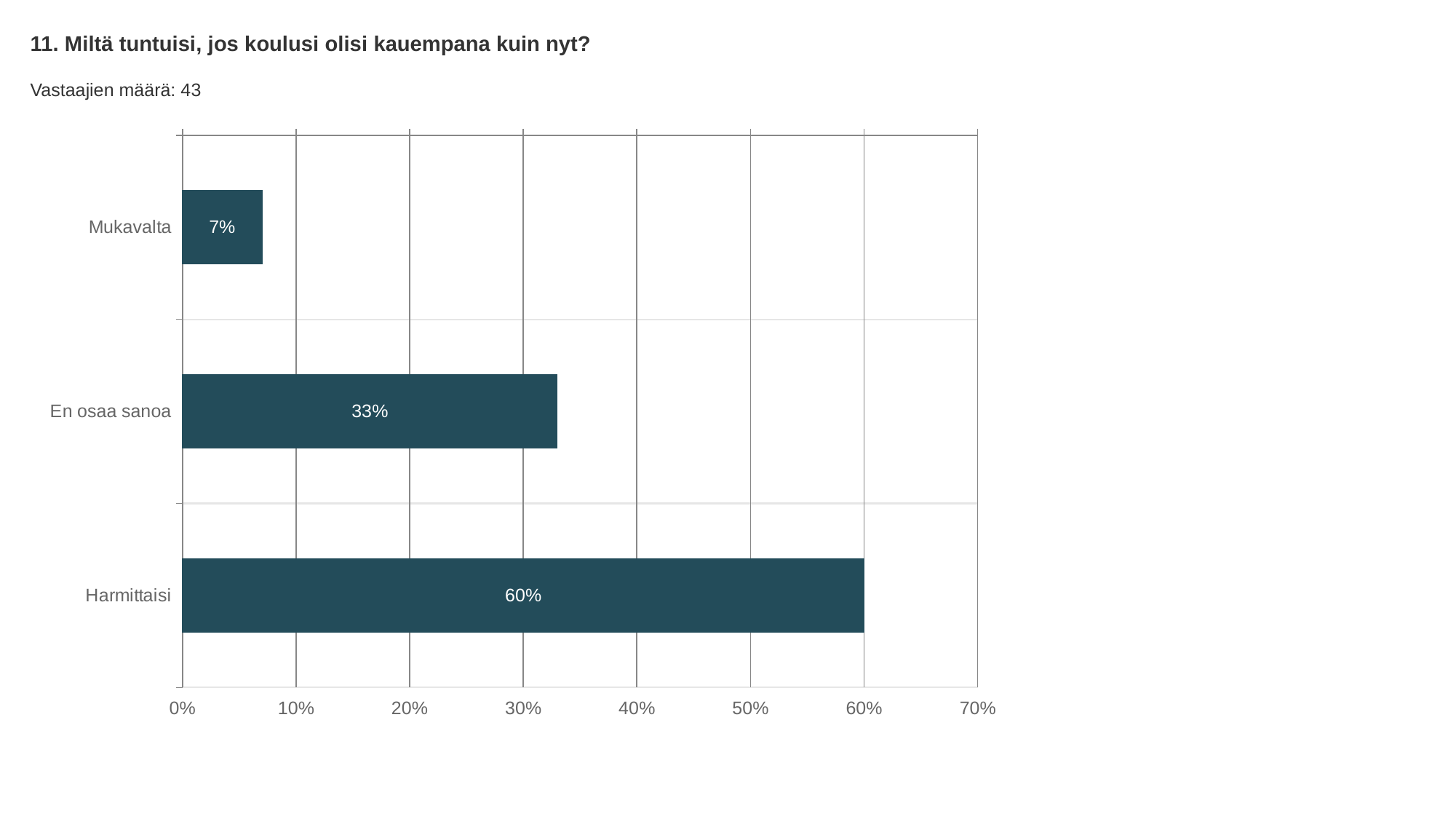
How many respondents (Vastaajien määrä) does the slide report? 43 What is the value for En osaa sanoa? 33% What kind of chart is shown on the slide? bar chart Which is larger, the value for En osaa sanoa or the value for Mukavalta? En osaa sanoa Is the value for En osaa sanoa greater or less than 40%? less What is the difference between the values for Harmittaisi and En osaa sanoa? 27% Which category has the lowest value? Mukavalta How many categories are shown in the chart? 3 What is the value for Mukavalta? 7% Which category has the highest value? Harmittaisi What is the value for Harmittaisi? 60% What is the difference between the values for En osaa sanoa and Mukavalta? 26%